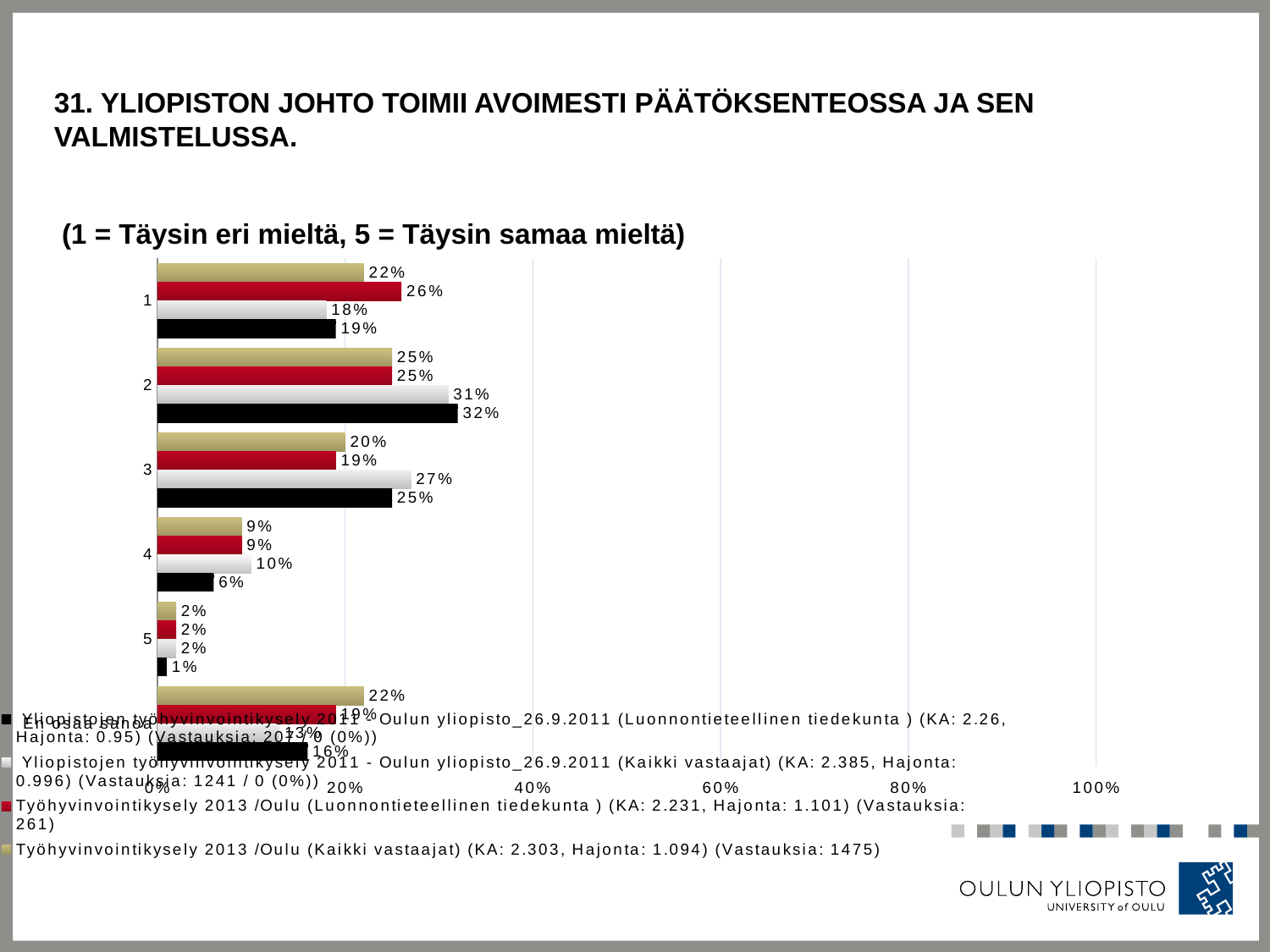
How many series does the legend list? 4 What is the value for category 1 in the Työhyvinvointikysely 2013 /Oulu (Luonnontieteellinen tiedekunta) series? 26% What kind of chart is shown on the slide? bar chart What is the value for category 2 in the Työhyvinvointikysely 2013 /Oulu (Kaikki vastaajat) series? 25% Which category has the lowest value in the Työhyvinvointikysely 2013 /Oulu (Kaikki vastaajat) series? 5 Which category has the highest value in the Yliopistojen työhyvinvointikysely 2011 (Luonnontieteellinen tiedekunta) series? 2 What is the value for category 4 in the Yliopistojen työhyvinvointikysely 2011 (Luonnontieteellinen tiedekunta) series? 6% What is the value for category 3 in the Yliopistojen työhyvinvointikysely 2011 (Kaikki vastaajat) series? 27% Is the value for category 2 in the Yliopistojen työhyvinvointikysely 2011 (Luonnontieteellinen tiedekunta) series greater or less than 20%? greater What is the difference between the Yliopistojen työhyvinvointikysely 2011 (Kaikki vastaajat) value and the Työhyvinvointikysely 2013 /Oulu (Kaikki vastaajat) value for category 2? 6% For category 1, which is larger: the Työhyvinvointikysely 2013 /Oulu (Luonnontieteellinen tiedekunta) value or the Yliopistojen työhyvinvointikysely 2011 (Kaikki vastaajat) value? Työhyvinvointikysely 2013 /Oulu (Luonnontieteellinen tiedekunta) What is the value for category 5 in the Yliopistojen työhyvinvointikysely 2011 (Luonnontieteellinen tiedekunta) series? 1%